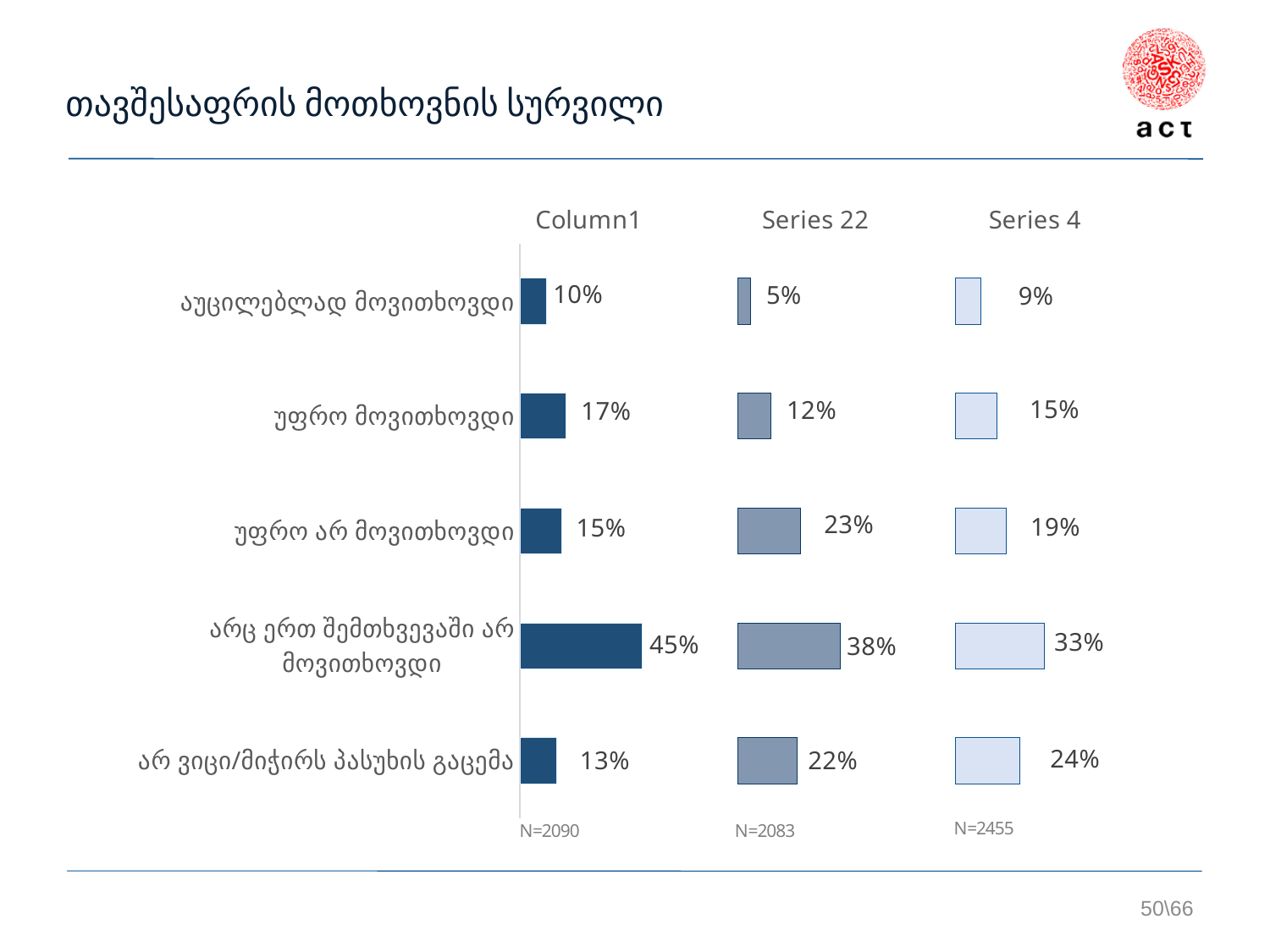
What is the difference between the Column1 and Series 4 values for "არც ერთ შემთხვევაში არ მოვითხოვდი"? 12% How many series does the chart show? 3 What kind of chart is shown on the slide? Bar chart Which is larger for "უფრო მოვითხოვდი": the Column1 value or the Series 22 value? Column1 What is the sample size (N) shown under the Series 4 column? N=2455 What is the Column1 value for "არც ერთ შემთხვევაში არ მოვითხოვდი"? 45% Which category has the lowest value in Column1? აუცილებლად მოვითხოვდი What is the Series 22 value for "უფრო არ მოვითხოვდი"? 23% What is the Series 22 value for "აუცილებლად მოვითხოვდი"? 5% What is the Series 4 value for "არ ვიცი/მიჭირს პასუხის გაცემა"? 24% How many categories are shown in the chart? 5 Which category has the highest value in Series 4? არც ერთ შემთხვევაში არ მოვითხოვდი